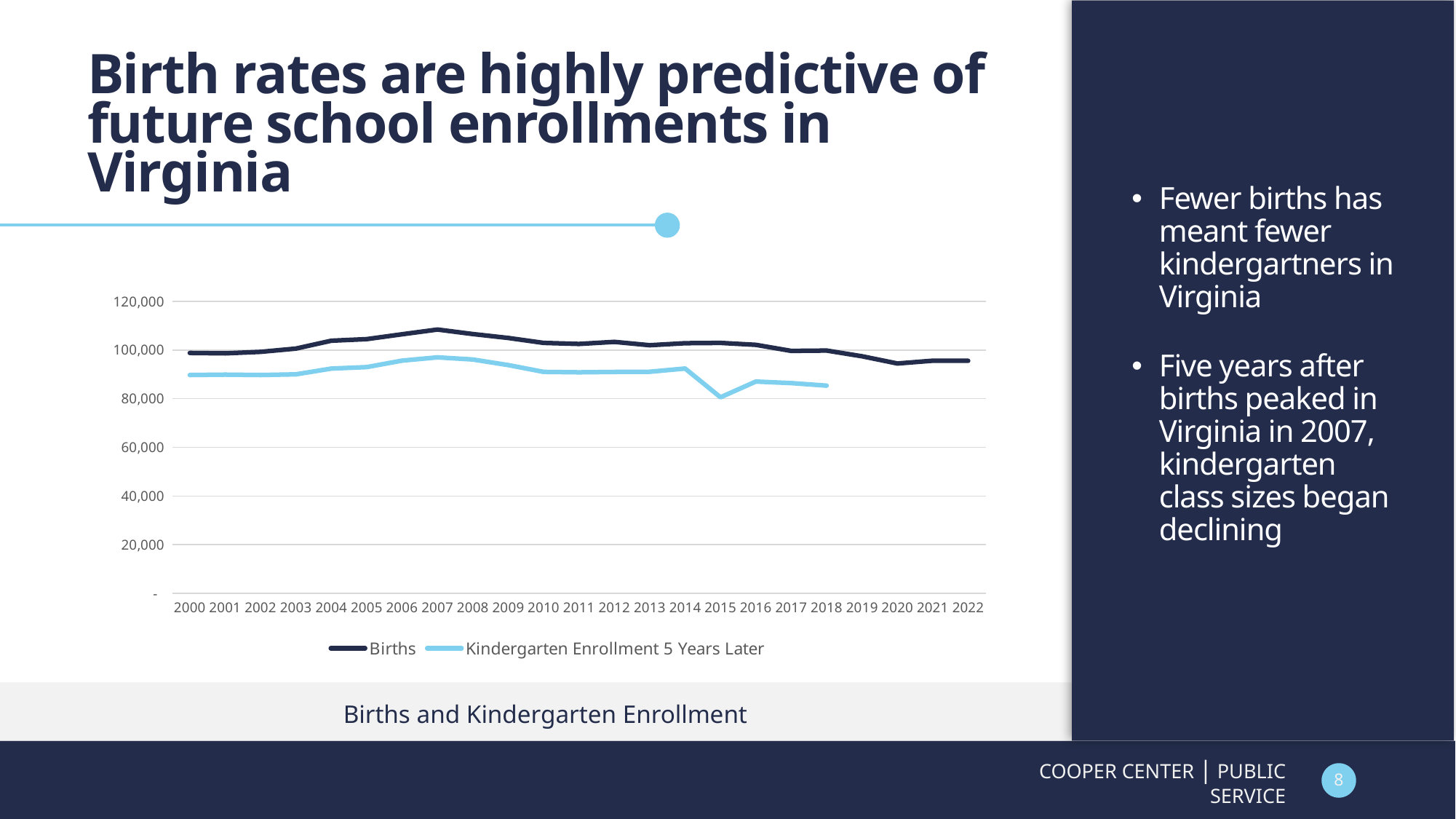
Is the value for Births in 2007 greater or less than 100,000? greater What are the two series named in the legend? Births; Kindergarten Enrollment 5 Years Later In which year is the Kindergarten Enrollment 5 Years Later series at its lowest? 2015 What is the title shown below the chart? Births and Kindergarten Enrollment How many series does the legend list? 2 Is the value for Births in 2022 greater or less than 100,000? less Is the value for Kindergarten Enrollment 5 Years Later in 2015 greater or less than 100,000? less How many years are shown on the x axis? 23 Does the Births series rise or fall between 2007 and 2020? Fall In 2015, which series has the higher value, Births or Kindergarten Enrollment 5 Years Later? Births What kind of chart is shown on the slide? Line chart In which year is the Births series at its highest? 2007